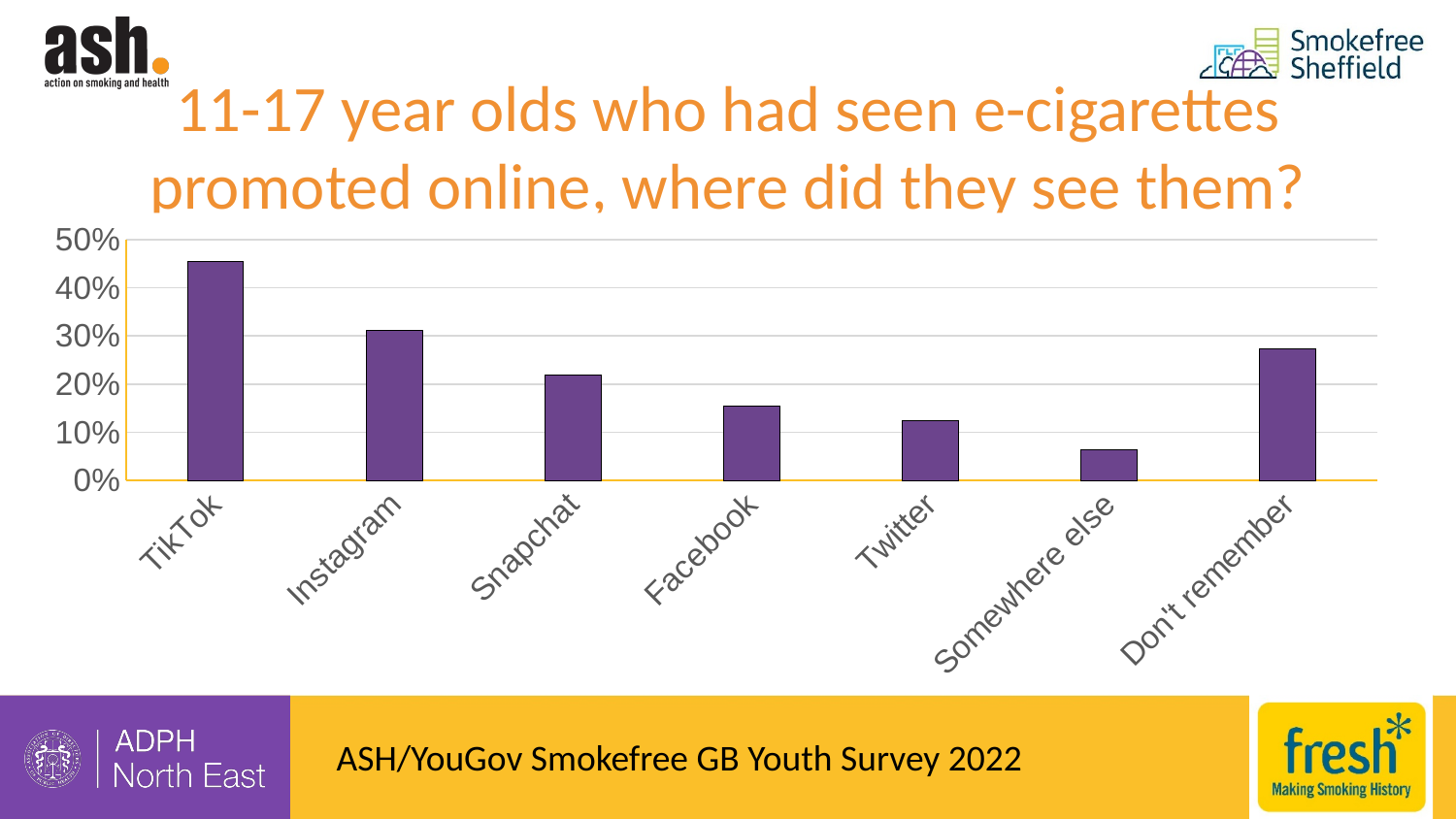
Which is larger, the value for Facebook or the value for Twitter? Facebook Which category has the highest value in the chart? TikTok Which is larger, the value for Don't remember or the value for Snapchat? Don't remember What kind of chart is shown on the slide? bar chart Which category has the lowest value in the chart? Somewhere else Is the value for TikTok greater or less than 40%? greater Is the value for Somewhere else greater or less than 10%? less What is the title of the chart on the slide? 11-17 year olds who had seen e-cigarettes promoted online, where did they see them? Is the value for Instagram greater or less than 40%? less How many categories are shown on the x axis of the chart? 7